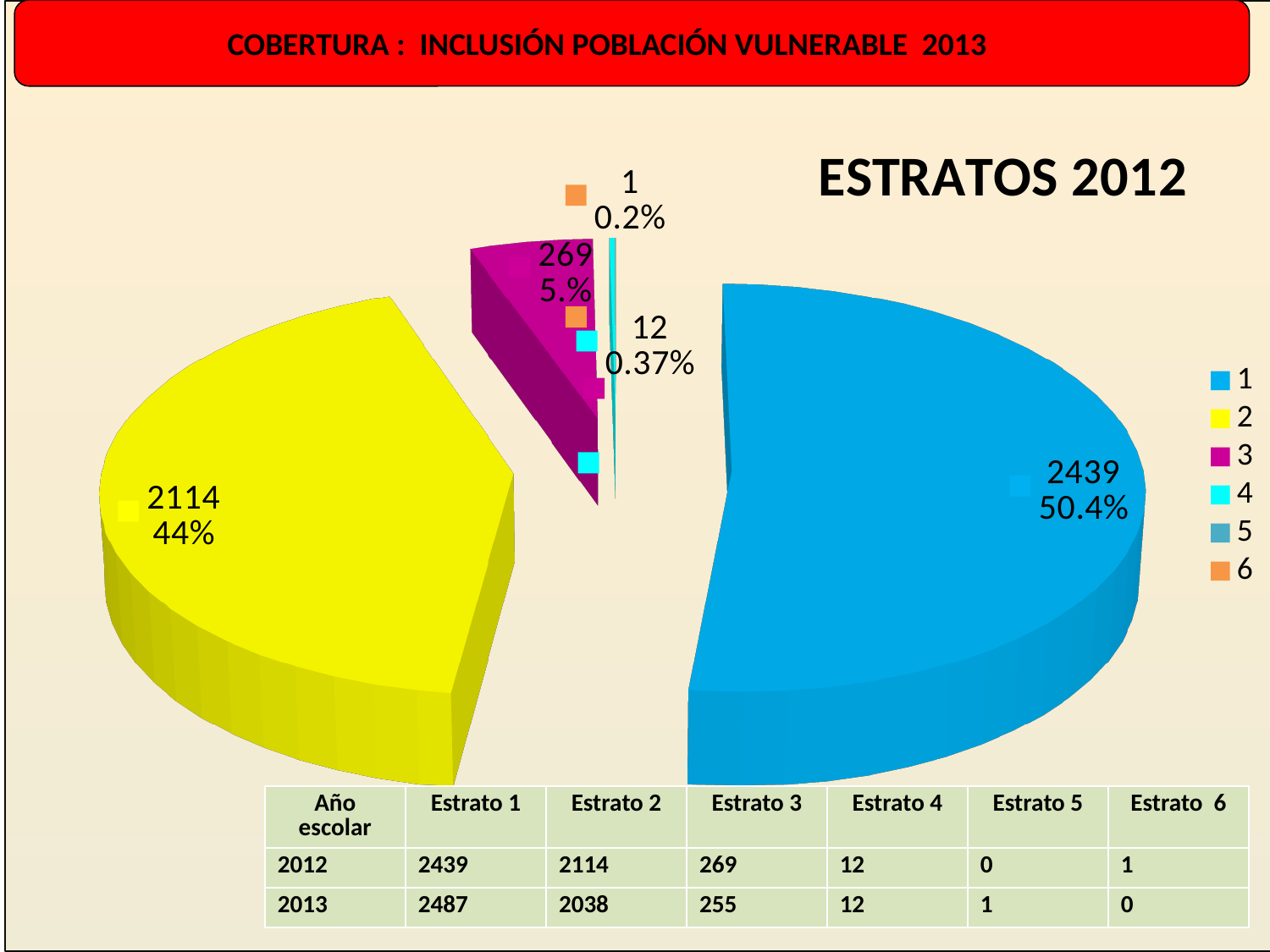
What type of chart is shown on the slide? pie chart What value is shown for estrato 3 in the pie chart? 269 What share of the pie does estrato 1 represent? 50.4% What share of the pie does estrato 2 represent? 44% Which is larger in the pie chart, the value for estrato 3 or the value for estrato 4? estrato 3 Which estrato has the largest slice of the pie? 1 What value is shown for estrato 2 in the pie chart? 2114 What is the title of the chart? ESTRATOS 2012 What value is shown for estrato 4 in the pie chart? 12 What is the difference between the values for estrato 1 and estrato 2 in the pie chart? 325 What value is shown for estrato 1 in the pie chart? 2439 How many entries does the chart legend list? 6